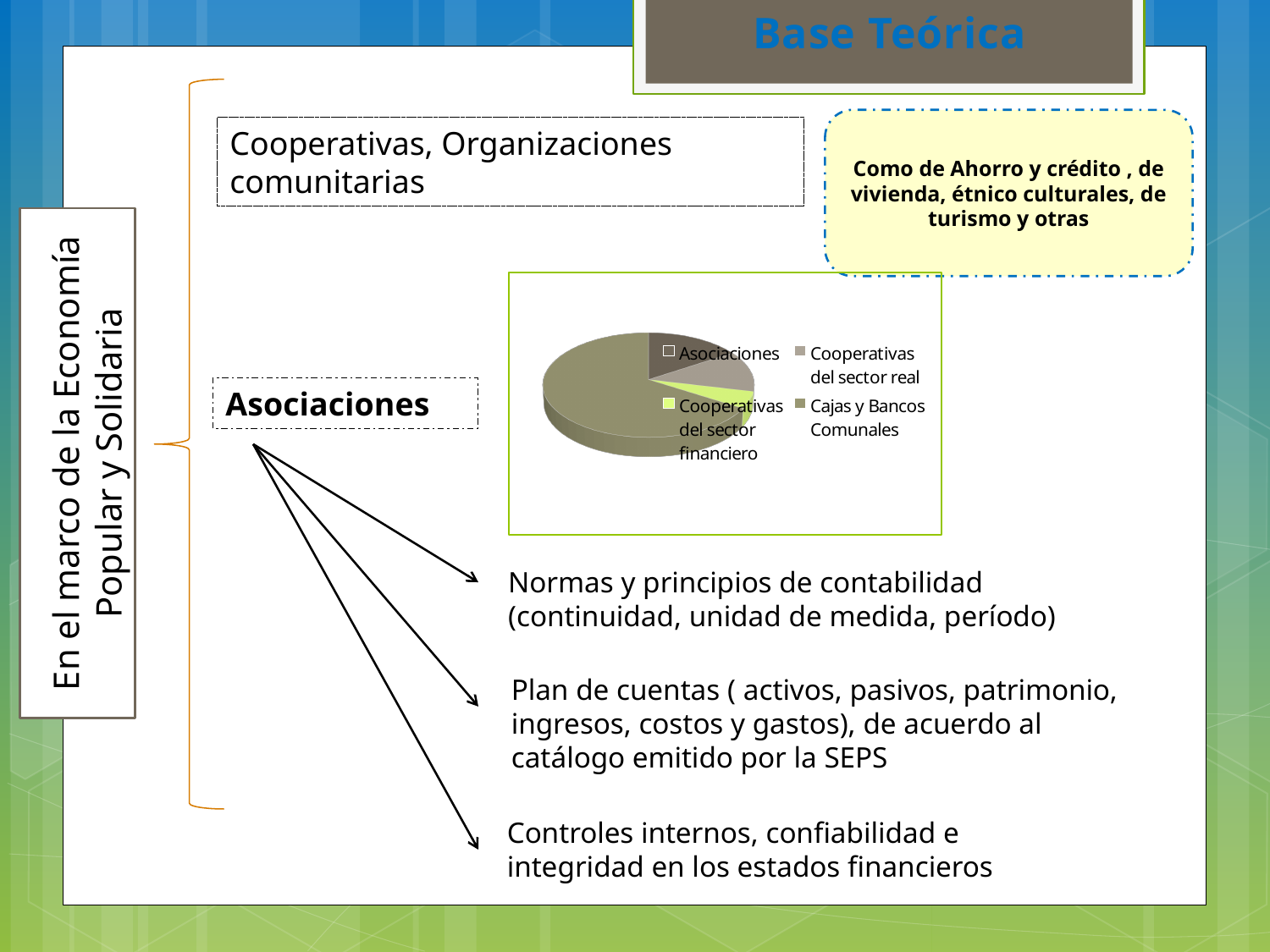
What kind of chart is shown on the slide? Pie chart In the pie chart, which slice is larger: Cajas y Bancos Comunales or Cooperativas del sector real? Cajas y Bancos Comunales Which legend entry in the pie chart is shown in light green? Cooperativas del sector financiero How many categories does the pie chart's legend list? 4 Which category has the largest slice in the pie chart? Cajas y Bancos Comunales In the pie chart, which slice is larger: Cajas y Bancos Comunales or Cooperativas del sector financiero? Cajas y Bancos Comunales Does the pie chart display data labels with values on its slices? No